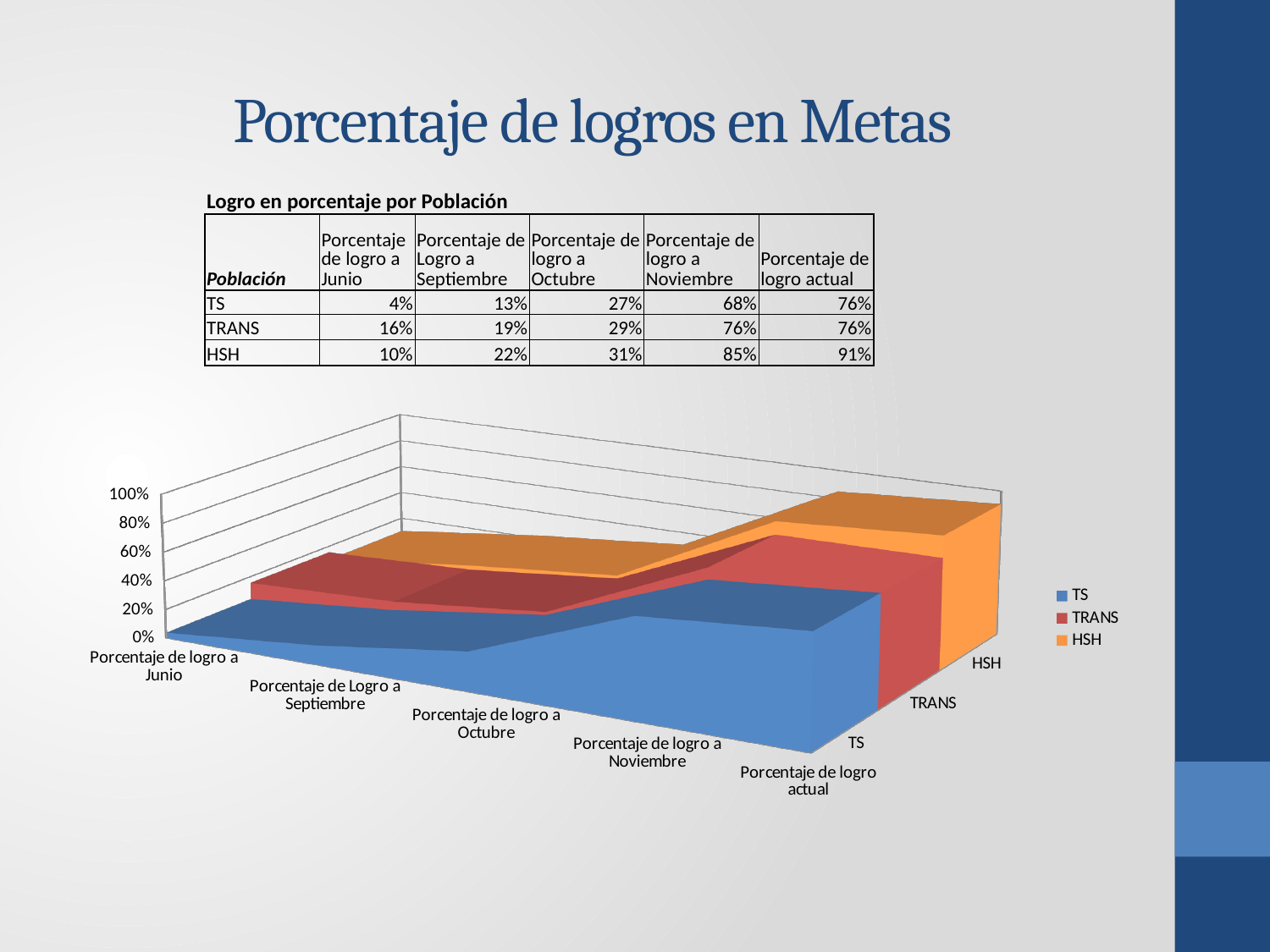
Is the value for TS at 'Porcentaje de logro actual' greater or less than 60%? greater Which series has the highest value at 'Porcentaje de logro actual'? HSH According to the slide, what is the value for HSH at 'Porcentaje de logro actual'? 91% Do the values for HSH rise or fall from 'Porcentaje de logro a Junio' to 'Porcentaje de logro actual'? rise What is the difference between the HSH and TS values at 'Porcentaje de logro a Noviembre'? 17% How many categories are shown along the x axis of the chart? 5 Which series does the orange area in the chart represent? HSH Which series has the lowest value at 'Porcentaje de logro a Junio'? TS How many series does the chart legend list? 3 According to the slide, what is the value for TS at 'Porcentaje de logro a Junio'? 4% According to the slide, what is the value for TRANS at 'Porcentaje de logro a Noviembre'? 76% What kind of chart is shown on the slide? 3D area chart